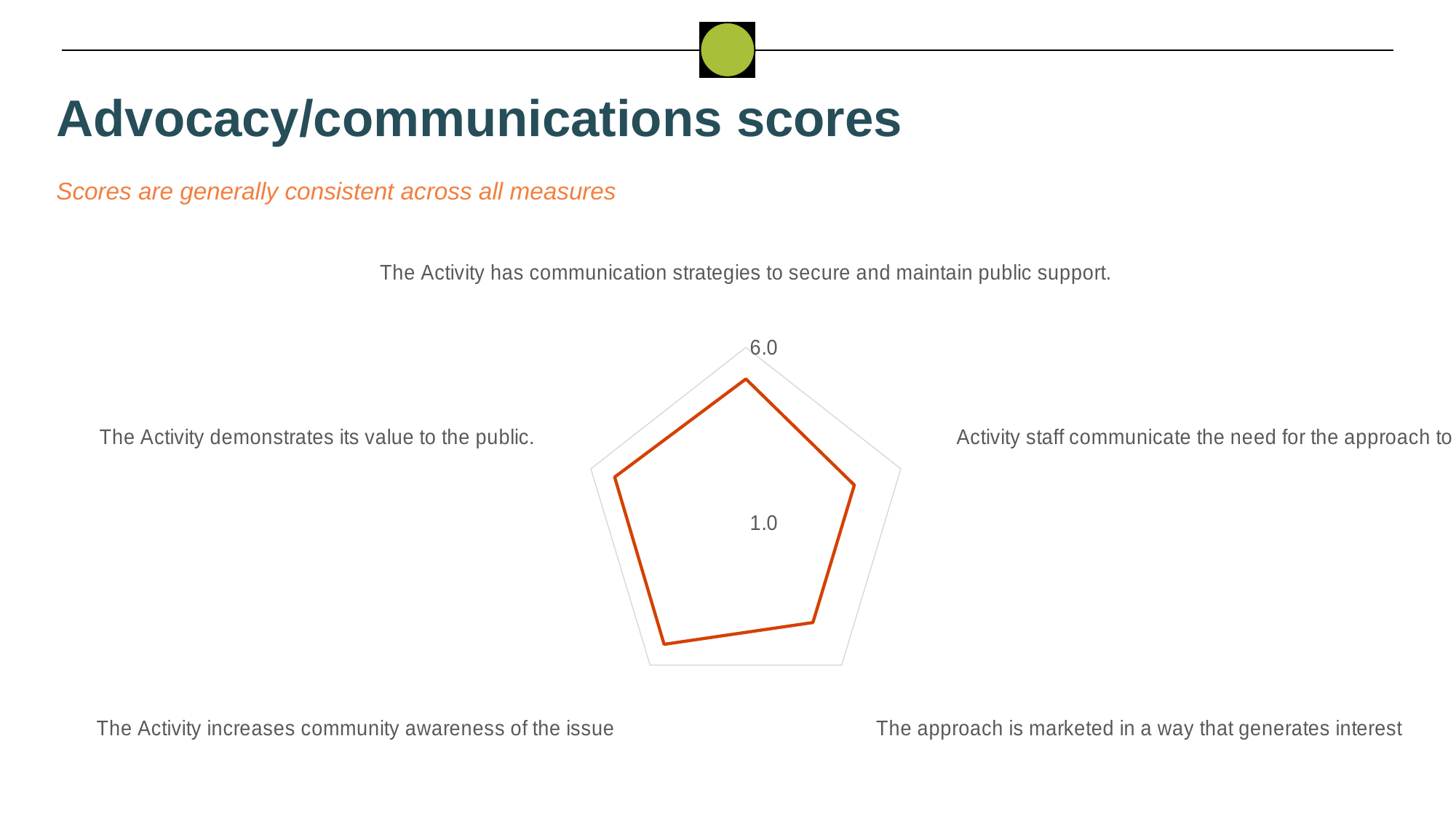
Is the value for "The Activity increases community awareness of the issue" greater or less than 1.0? greater What is the highest axis tick value shown on the radar chart? 6.0 Is the value for "The Activity has communication strategies to secure and maintain public support." greater or less than 6.0? less What kind of chart is shown on the slide? Radar chart How many categories (axes) does the radar chart have? 5 What is the lowest axis tick value shown on the radar chart? 1.0 Is the value for "The approach is marketed in a way that generates interest" greater or less than 6.0? less Which category label appears at the top of the radar chart? The Activity has communication strategies to secure and maintain public support. Which category label appears at the bottom left of the radar chart? The Activity increases community awareness of the issue